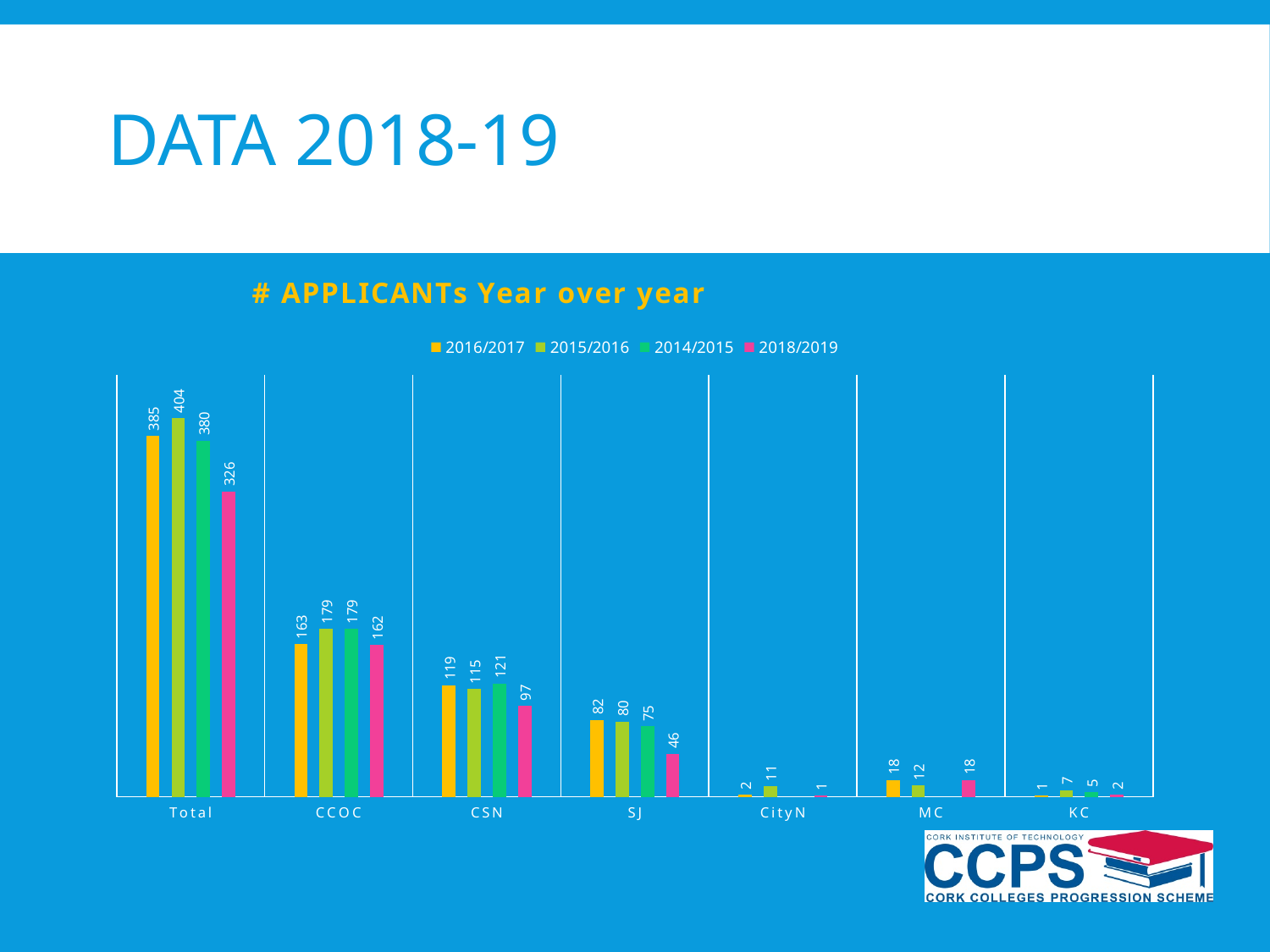
How many categories are shown on the x axis? 7 What is the difference between the Total values for 2016/2017 and 2018/2019? 59 Which year has the highest value for Total? 2015/2016 What kind of chart is shown on the slide? bar chart What is the value for CSN in 2018/2019? 97 What is the value for SJ in 2014/2015? 75 How many series does the legend list? 4 What is the value for KC in 2015/2016? 7 Which is larger, the CCOC value for 2016/2017 or for 2018/2019? 2016/2017 Which year has the lowest value for SJ? 2018/2019 What is the value for Total in 2015/2016? 404 What is the title of the chart? # APPLICANTs Year over year